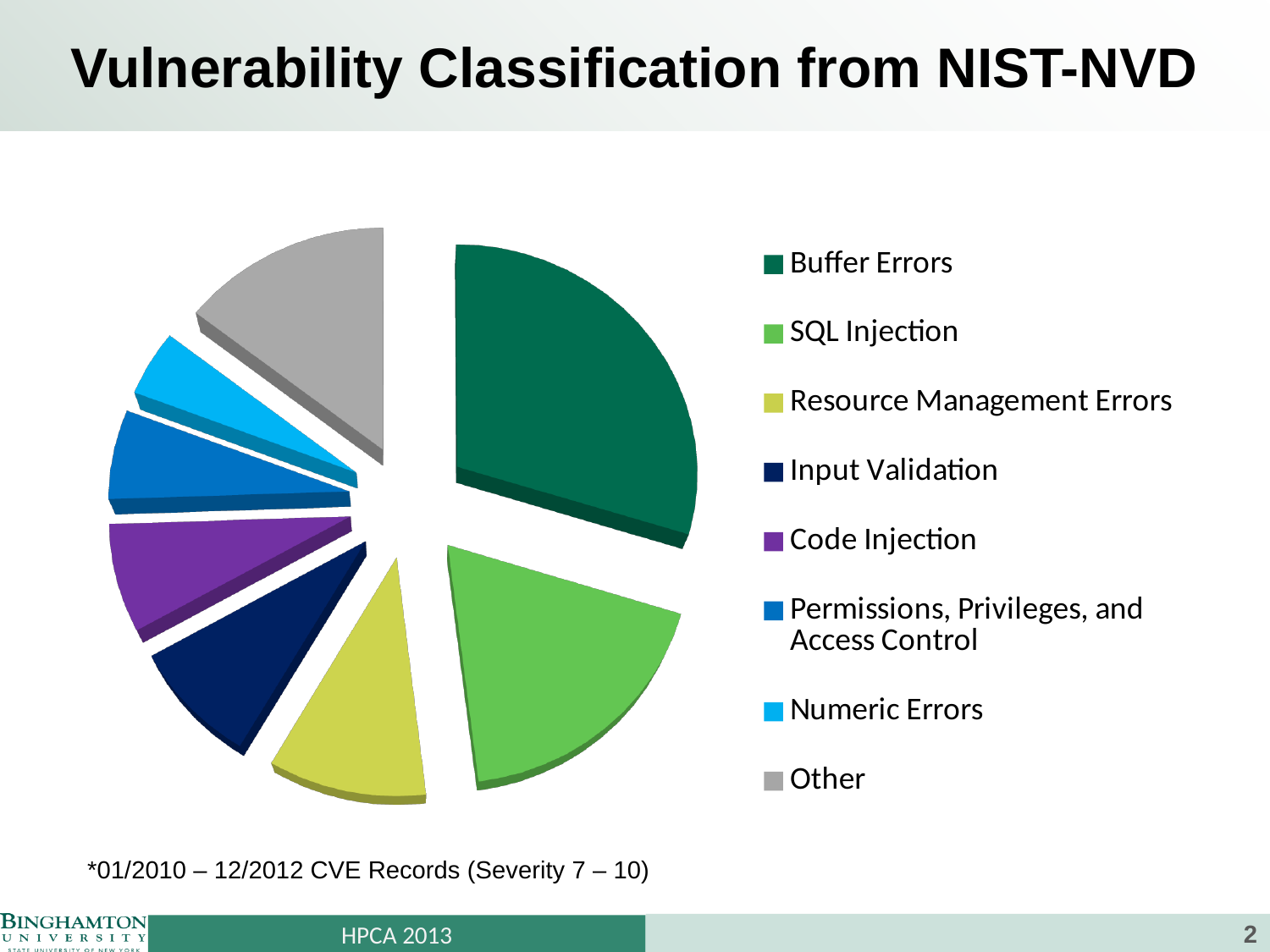
Which category has the largest slice of the pie? Buffer Errors Which slice is larger, SQL Injection or Numeric Errors? SQL Injection Which slice is larger, Buffer Errors or Other? Buffer Errors Which slice is larger, Resource Management Errors or Numeric Errors? Resource Management Errors What kind of chart is shown on the slide? pie chart How many categories does the pie chart show? 8 What colour is the Buffer Errors slice in the pie chart? dark green What is the title of the slide containing the pie chart? Vulnerability Classification from NIST-NVD